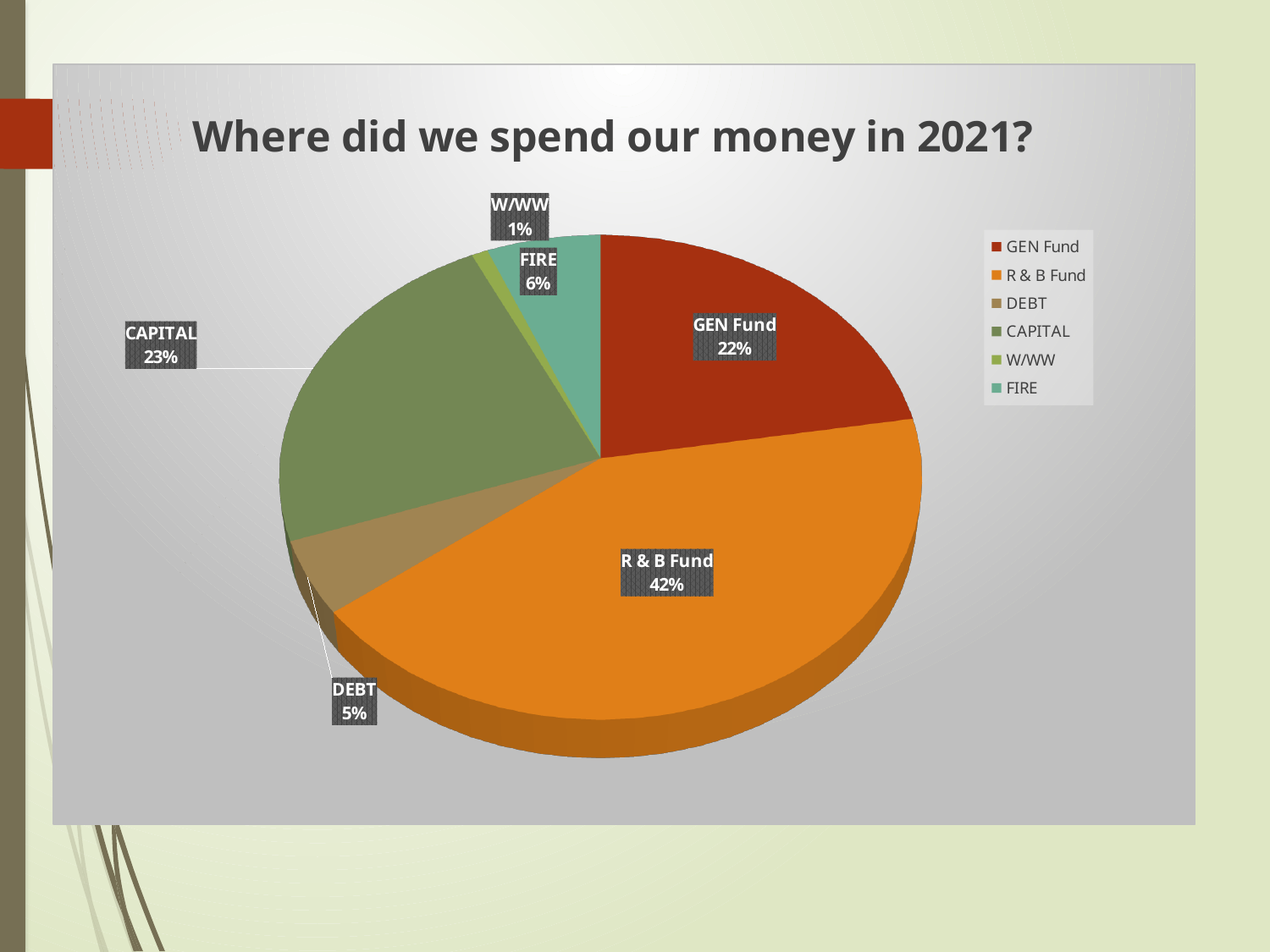
Which category has the smallest slice of the pie? W/WW Which is larger, the FIRE slice or the DEBT slice? FIRE What is the difference in percentage points between the R & B Fund and the GEN Fund? 20 What type of chart is shown on the slide? Pie chart What is the title of the chart? Where did we spend our money in 2021? Which category has the largest slice of the pie? R & B Fund What percentage is shown for DEBT? 5% What share does the GEN Fund slice represent? 22% What percentage is shown for W/WW? 1% How many categories are shown in the pie chart? 6 What percentage of the pie is CAPITAL? 23% What share of spending went to the R & B Fund? 42%